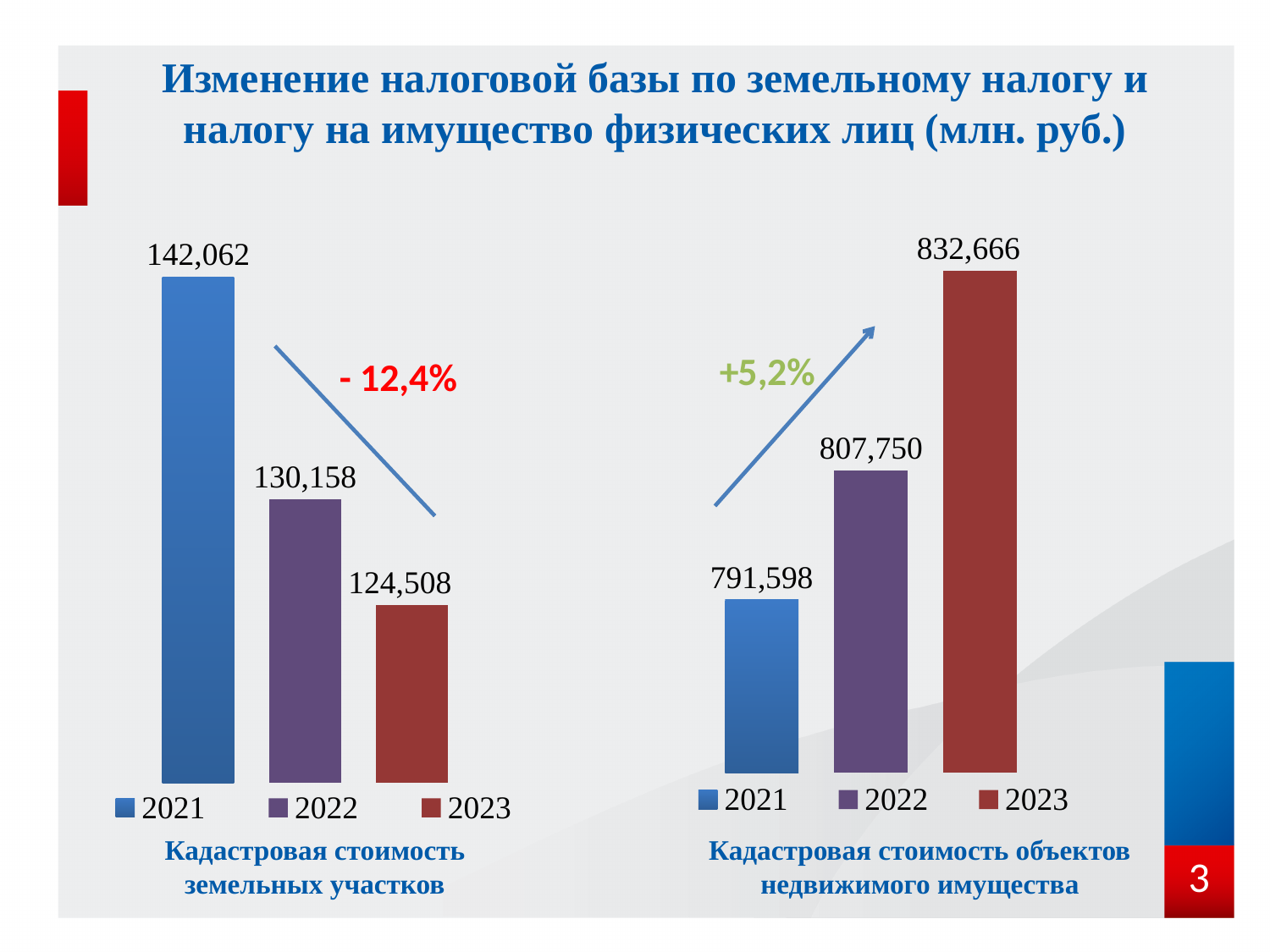
In the left chart (Кадастровая стоимость земельных участков), what is the value for 2021? 142,062 How many entries does the legend of the right chart (Кадастровая стоимость объектов недвижимого имущества) list? 3 In the left chart (Кадастровая стоимость земельных участков), what is the value for 2023? 124,508 How many bars are shown in the left chart (Кадастровая стоимость земельных участков)? 3 In the right chart (Кадастровая стоимость объектов недвижимого имущества), which year has the highest value? 2023 In the right chart (Кадастровая стоимость объектов недвижимого имущества), what is the difference between the 2023 and 2021 values? 41,068 In the right chart (Кадастровая стоимость объектов недвижимого имущества), what is the value for 2022? 807,750 What kind of chart is the left chart (Кадастровая стоимость земельных участков)? Bar chart In the right chart (Кадастровая стоимость объектов недвижимого имущества), which is larger, the value for 2021 or the value for 2022? 2022 In the left chart (Кадастровая стоимость земельных участков), which year has the lowest value? 2023 In the left chart (Кадастровая стоимость земельных участков), what is the difference between the 2021 and 2023 values? 17,554 In the left chart (Кадастровая стоимость земельных участков), do the values rise or fall from 2021 to 2023? Fall